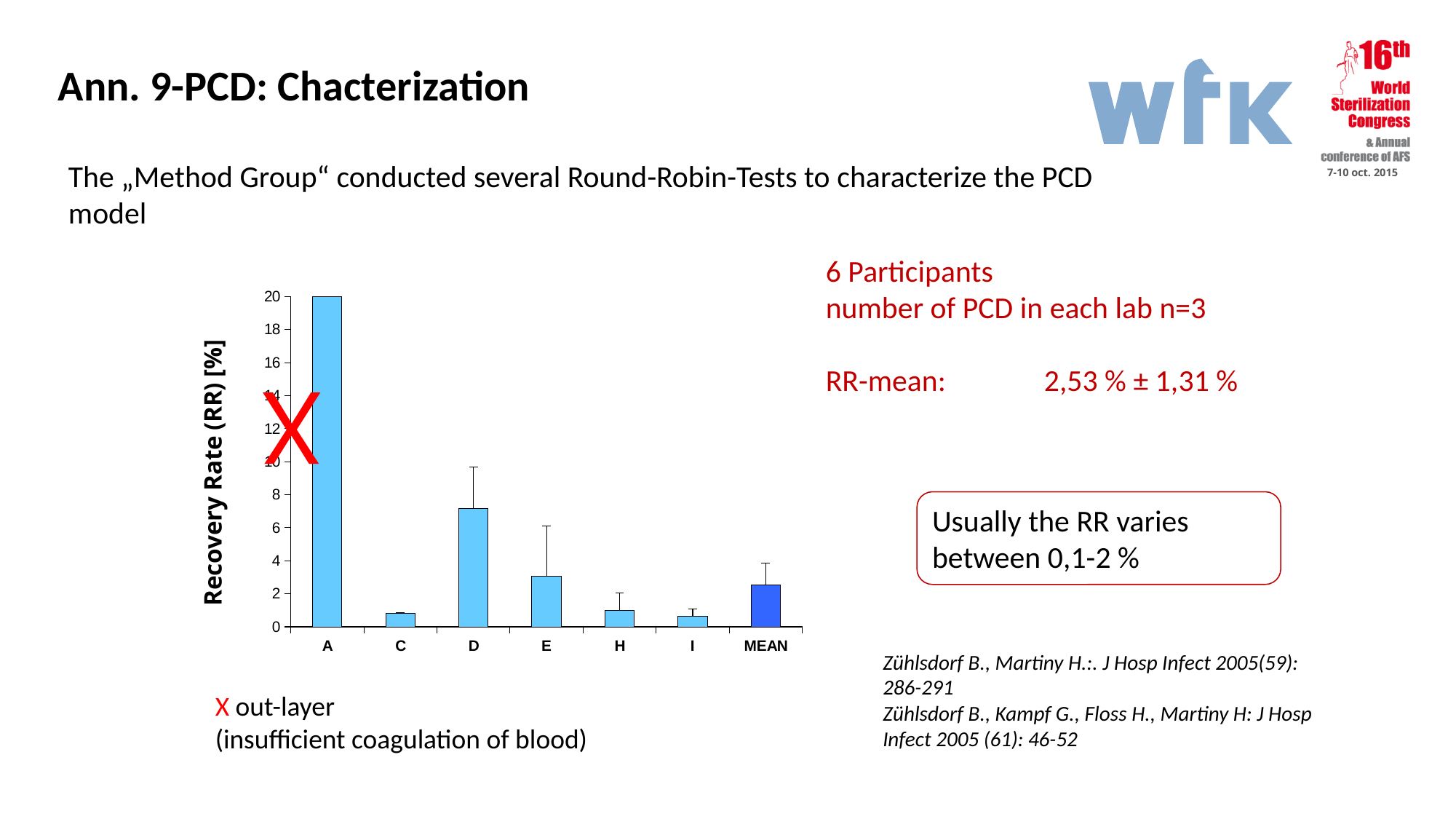
Which category's bar is marked with a red X as an out-layer? A Which has the larger recovery rate, D or E? D Is the recovery rate for MEAN greater or less than 4? less Is the recovery rate for A greater or less than 18? greater How many categories are shown on the x axis of the chart? 7 Is the recovery rate for D greater or less than 6? greater Which has the larger recovery rate, E or H? E What kind of chart is shown on the slide? bar chart Which has the larger recovery rate, D or MEAN? D Which category has the highest recovery rate in the chart? A What is the label of the y axis of the chart? Recovery Rate (RR) [%]